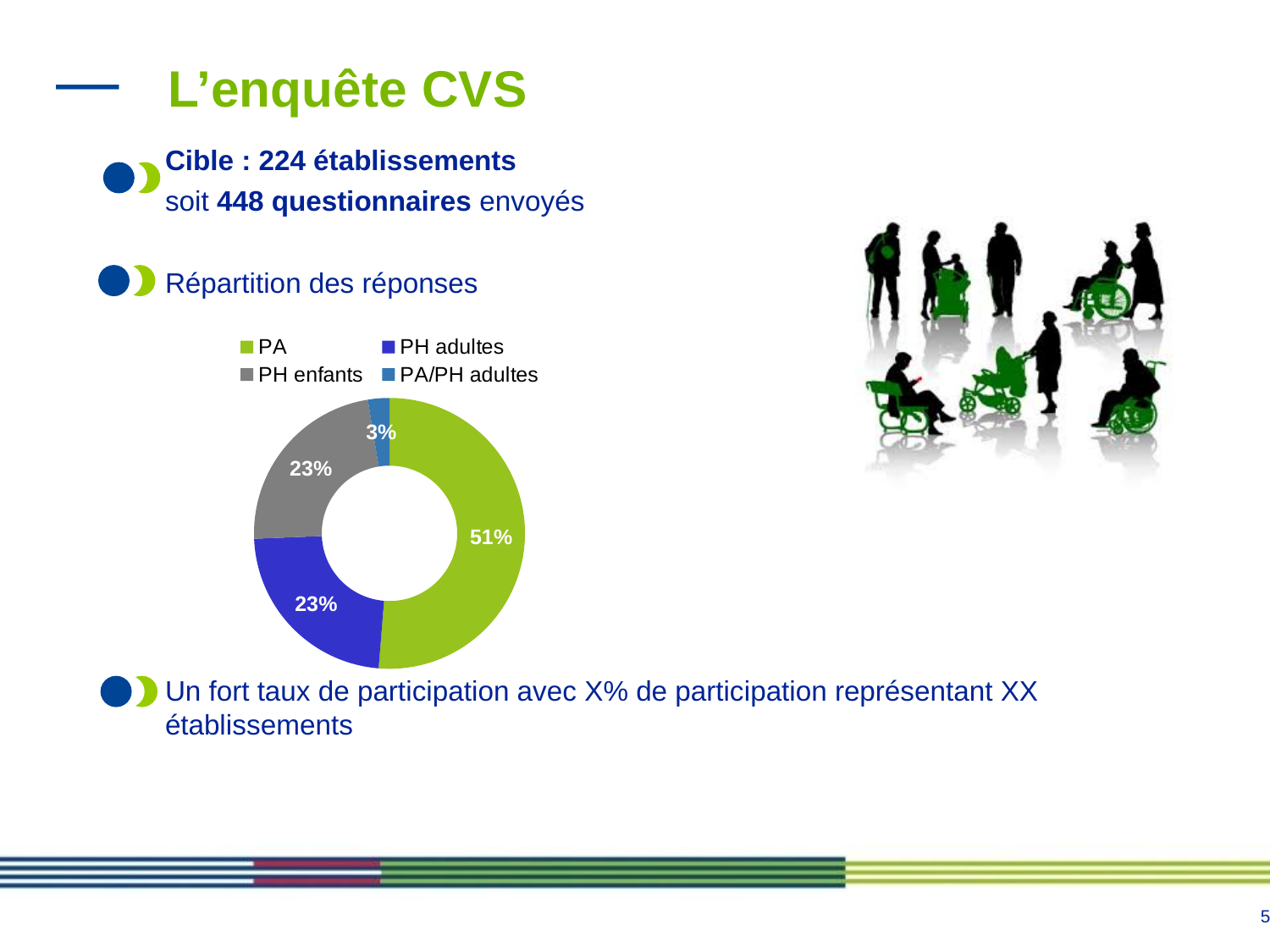
Which category has the smallest share in the chart? PA/PH adultes What percentage is shown for PA/PH adultes in the chart? 3% How many categories are shown in the chart? 4 How many entries does the chart legend list? 4 Which is larger, the share for PA or the share for PH enfants? PA What share of responses does the PA category represent in the doughnut chart? 51% What percentage is shown for PH enfants in the chart? 23% How many percentage points larger is the PA share than the PH adultes share? 28 What colour is used for the PA segment in the chart? Green Which category has the largest share in the chart? PA What type of chart is used to show the 'Répartition des réponses'? Doughnut (pie) chart What percentage is shown for PH adultes in the chart? 23%